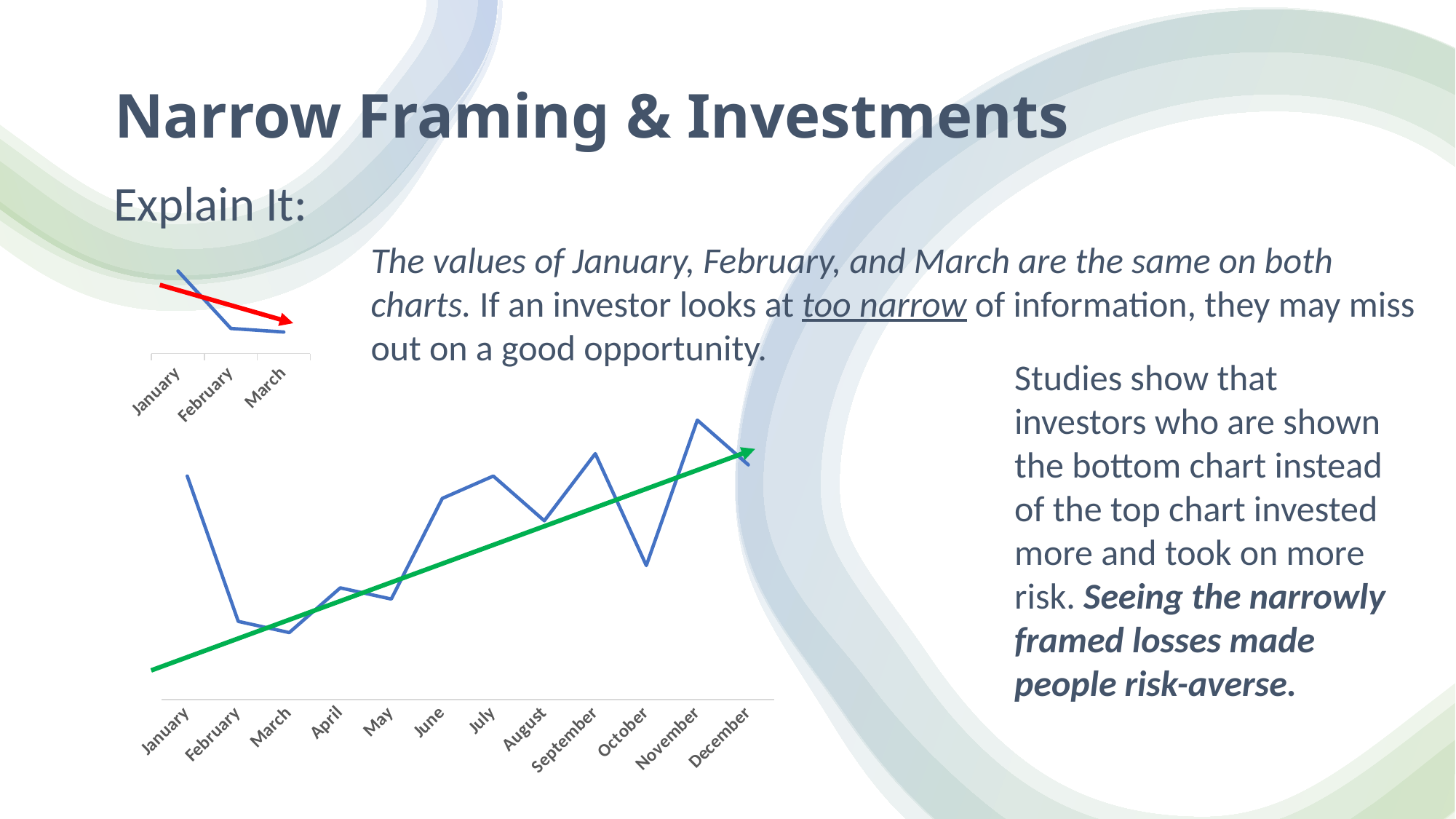
How many months are shown on the x axis of the bottom chart? 12 What colour is the arrow drawn over the top chart? red In the bottom chart, which is higher, the value for July or the value for August? July In the top chart, do the values rise or fall from January to March? fall What colour is the arrow drawn over the bottom chart? green In the bottom chart, which is higher, the value for September or the value for October? September How many months are shown on the x axis of the top chart? 3 In the bottom chart, which month has the highest value? November In the top chart, which month has the highest value? January What kind of chart is the bottom chart on the slide? line chart In the bottom chart, do the values overall rise or fall from January to December? rise What kind of chart is the top chart on the slide? line chart